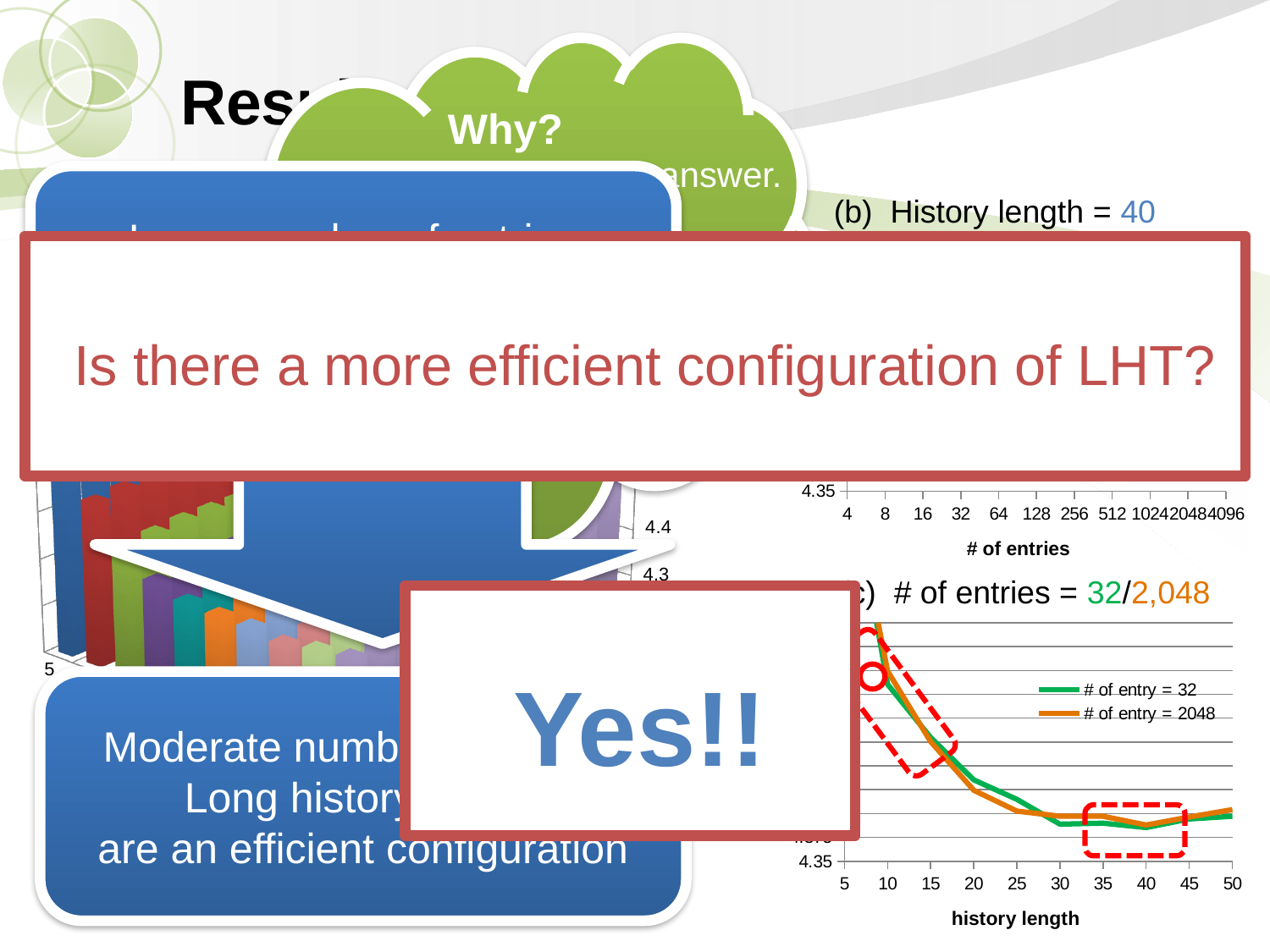
How many tick labels are shown on the x axis of chart (b)? 11 How many series does the legend of chart (c) list? 2 How many tick labels are shown on the x axis of chart (c)? 10 In chart (c), at history length 10, which series has the higher value: # of entry = 32 or # of entry = 2048? # of entry = 2048 What is the lowest y-axis tick value shown on chart (c)? 4.35 What is the x-axis title of chart (b) History length = 40? # of entries What is the lowest y-axis tick value shown on chart (b)? 4.35 In chart (c), do the values rise or fall as history length increases from 5 to 30? fall What kind of chart is the chart labelled (c) # of entries = 32/2,048? line chart What are the two legend entries in chart (c)? # of entry = 32 and # of entry = 2048